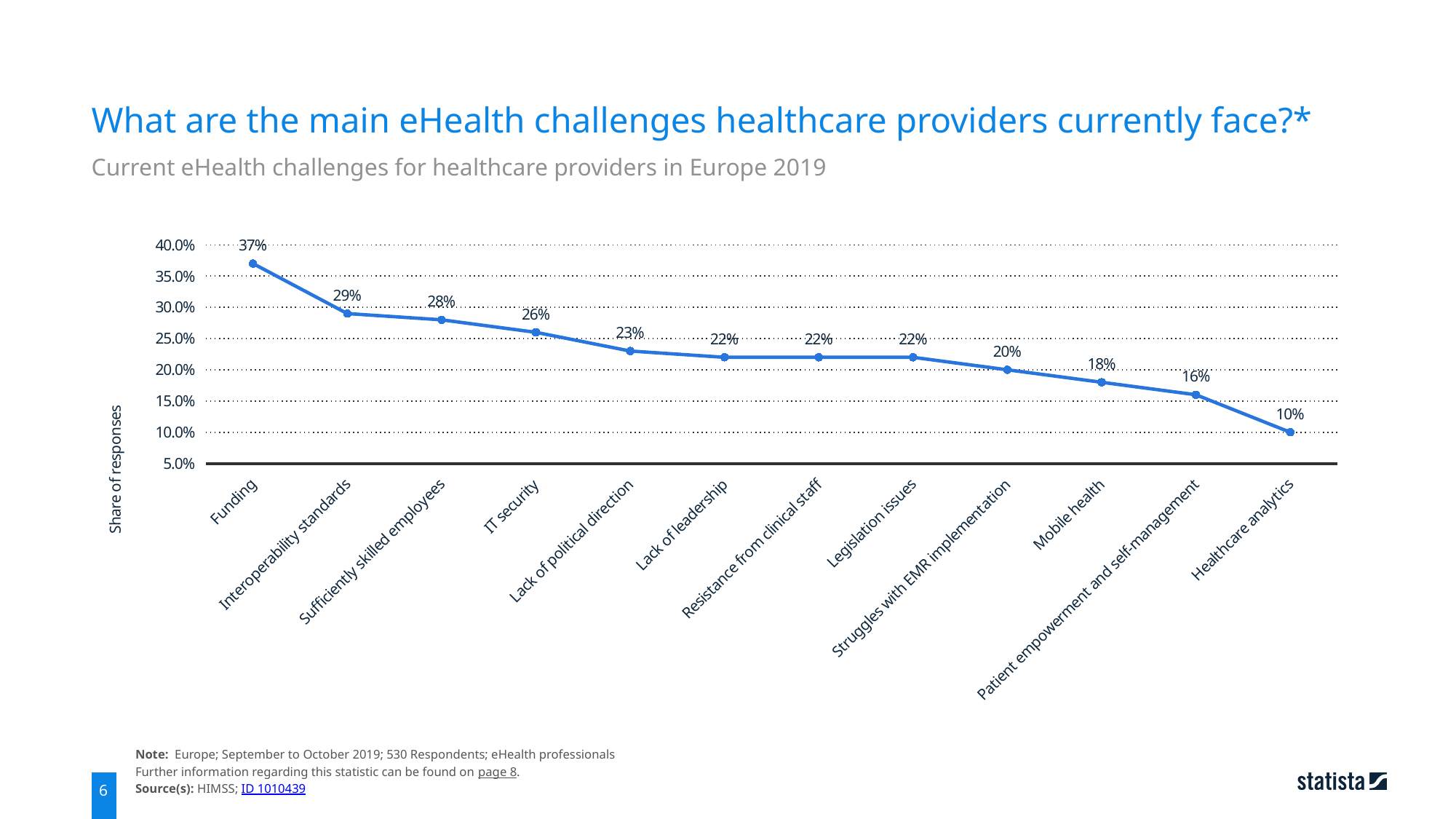
Which has a larger share of responses, Sufficiently skilled employees or Lack of political direction? Sufficiently skilled employees Which challenge has the lowest share of responses? Healthcare analytics What is the difference between the share for Interoperability standards and the share for Struggles with EMR implementation? 9% Do the values rise or fall from left to right along the x axis? Fall What share of responses is shown for Mobile health? 18% How many challenges are plotted on the chart? 12 What share of responses is shown for Funding? 37% What is the difference between the share for Funding and the share for Healthcare analytics? 27% Is the value for Patient empowerment and self-management greater or less than 20.0%? less Which challenge has the highest share of responses? Funding What share of responses is shown for IT security? 26% What kind of chart is shown on the slide? Line chart